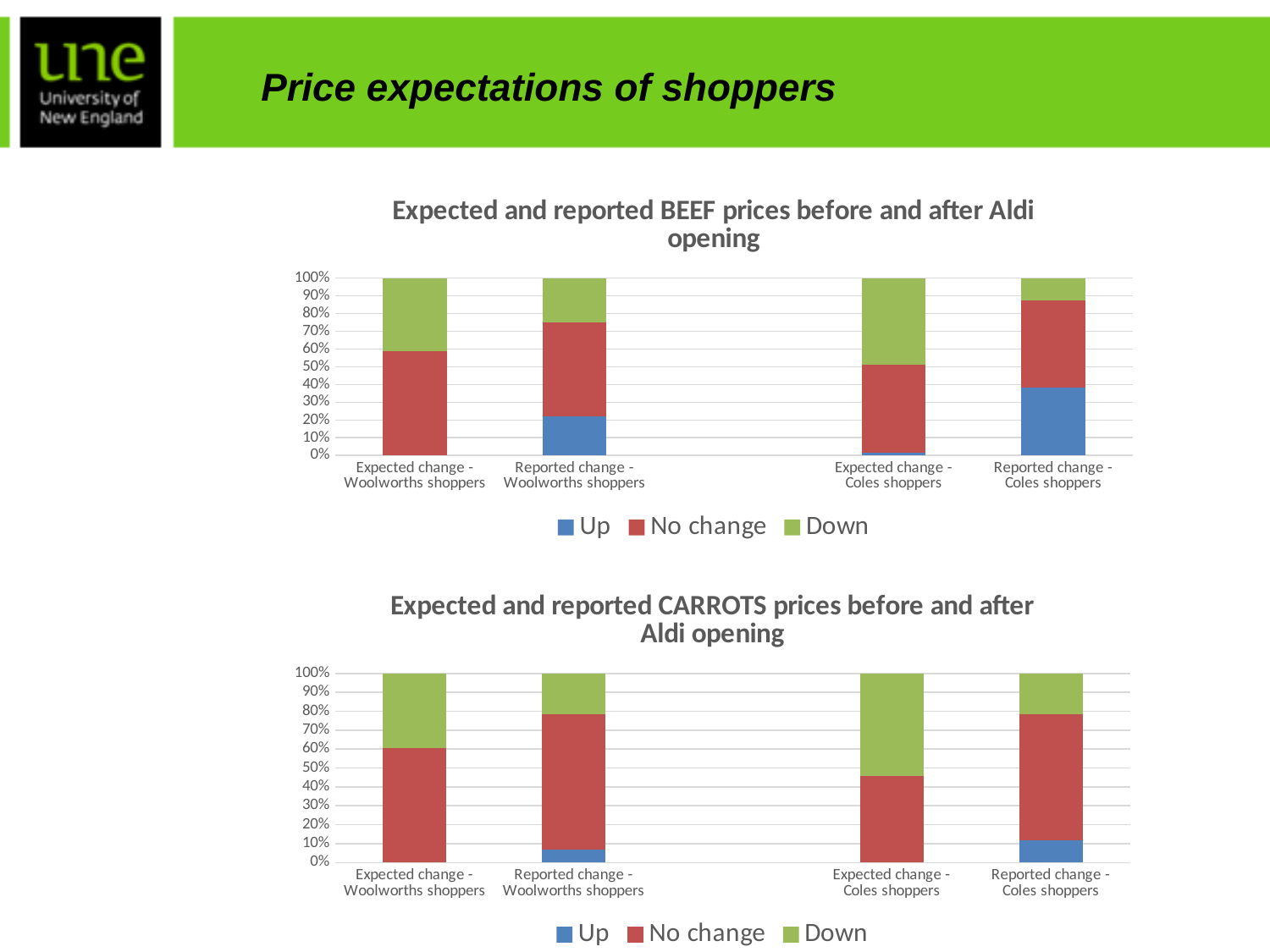
Which colour represents 'No change' on the CARROTS chart? Red On the BEEF chart, is the 'Up' value for 'Reported change - Woolworths shoppers' greater or less than 30%? less What are the three legend entries on the BEEF chart? Up, No change, Down How many series does the legend list on the 'Expected and reported CARROTS prices before and after Aldi opening' chart? 3 On the BEEF chart, what is the total height of the stacked bar for 'Reported change - Coles shoppers'? 100% What kind of chart is the 'Expected and reported BEEF prices before and after Aldi opening' chart? Stacked bar chart On the BEEF chart, which category has the largest 'Up' segment? Reported change - Coles shoppers On the BEEF chart, is the 'Up' value for 'Reported change - Coles shoppers' greater or less than 30%? greater On the BEEF chart, which has the larger 'Down' segment: 'Expected change - Woolworths shoppers' or 'Reported change - Coles shoppers'? Expected change - Woolworths shoppers On the CARROTS chart, which category has the largest 'Down' segment? Expected change - Coles shoppers How many shopper categories are shown along the x axis of the BEEF chart? 4 On the CARROTS chart, is the 'Up' value for 'Reported change - Woolworths shoppers' greater or less than 10%? less